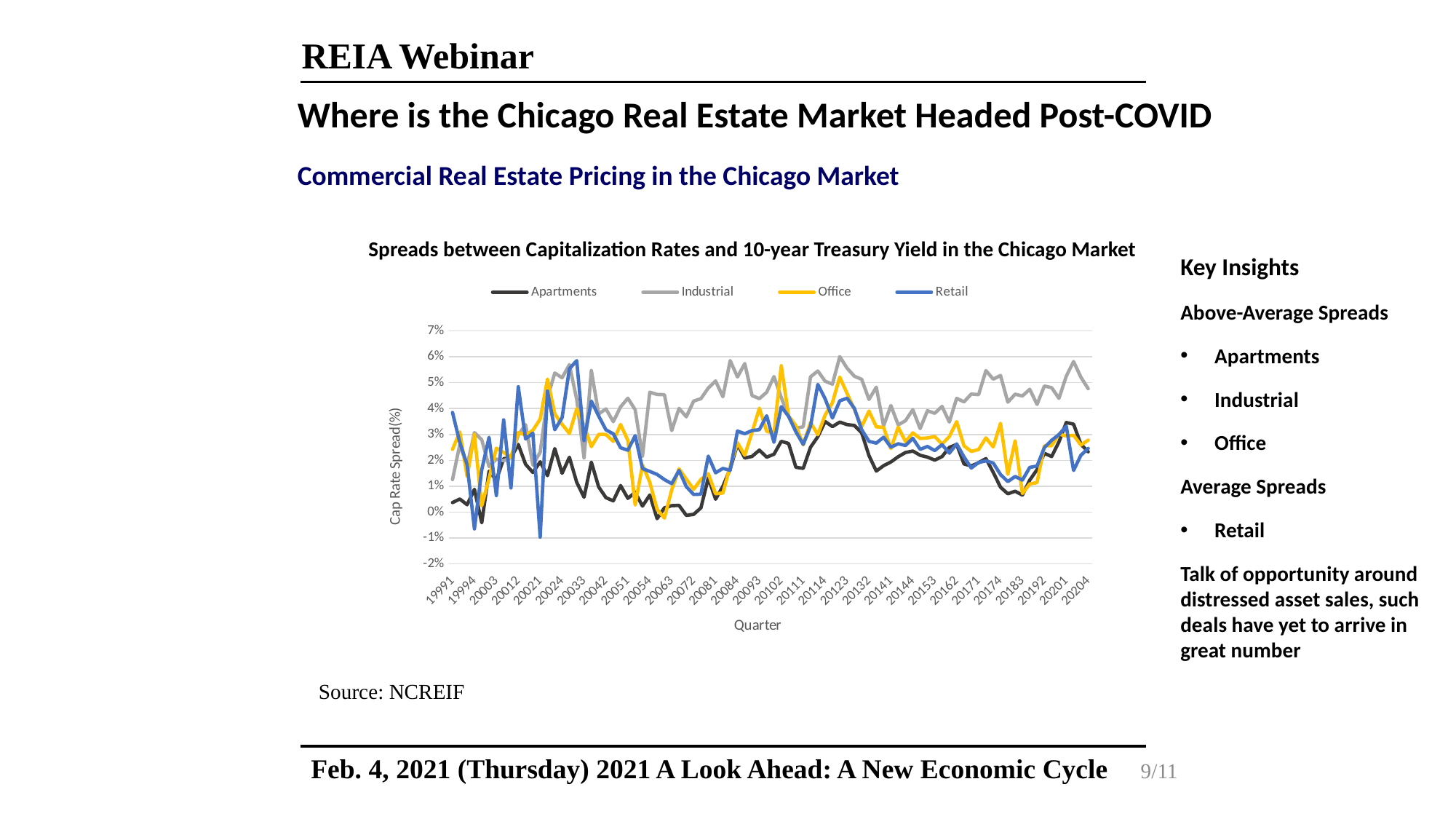
Is the Industrial value at 20204 greater or less than 4%? greater Is the Retail value at 20021 greater or less than 0%? less Which series is highest at the last quarter shown (20204)? Industrial Is the Apartments value at 20183 greater or less than 1%? less What is the lowest value shown on the vertical axis of the chart? -2% At 20204, which is larger, the Industrial value or the Apartments value? Industrial What is the title of the chart? Spreads between Capitalization Rates and 10-year Treasury Yield in the Chicago Market What is the label on the vertical axis of the chart? Cap Rate Spread(%) What kind of chart is shown on the slide? line chart At 20183, which is larger, the Industrial value or the Office value? Industrial How many series does the chart's legend list? 4